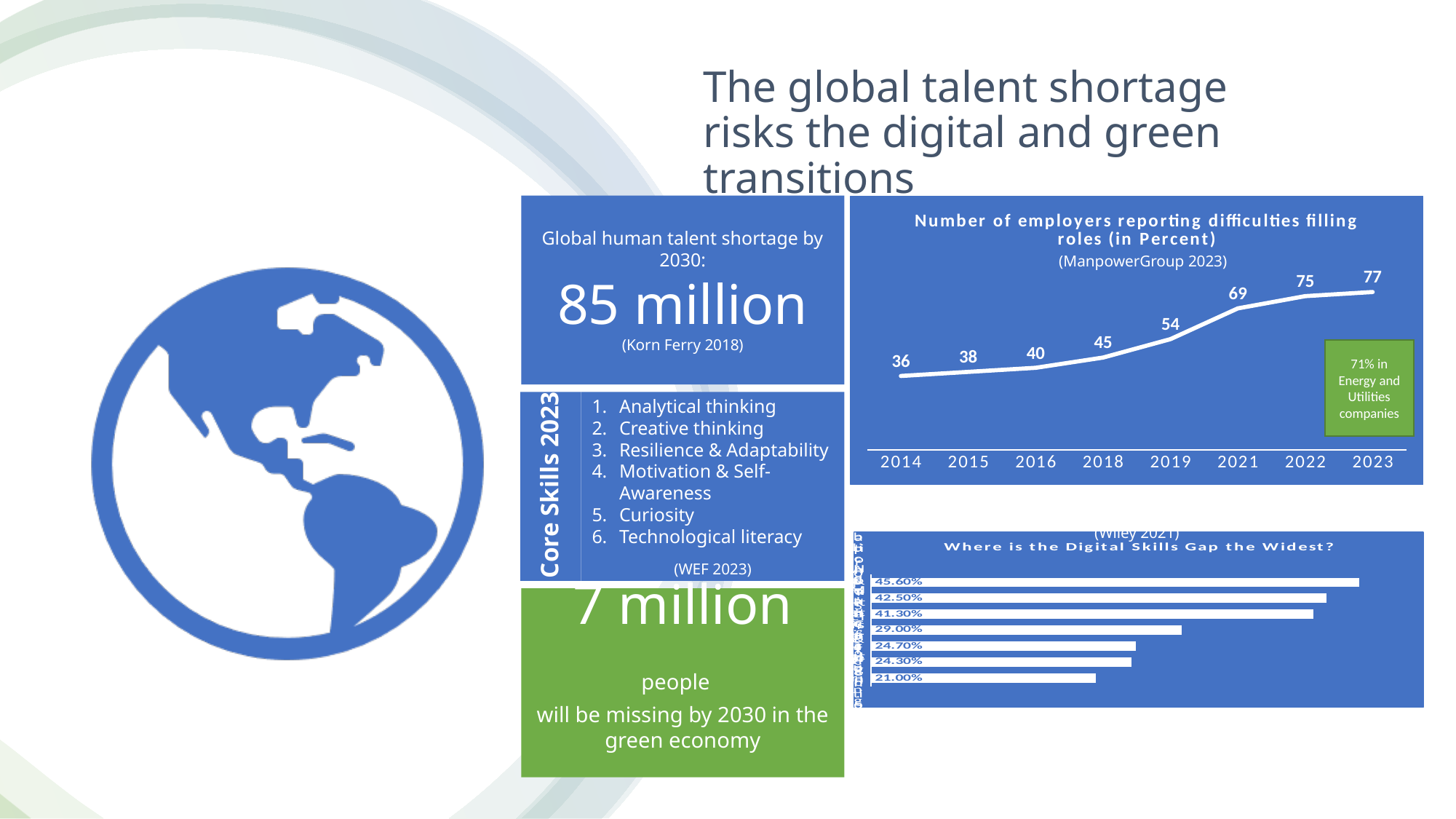
In the chart titled "Number of employers reporting difficulties filling roles (in Percent)", what is the value for 2023? 77 In the chart titled "Number of employers reporting difficulties filling roles (in Percent)", what is the value for 2019? 54 In the chart titled "Number of employers reporting difficulties filling roles (in Percent)", how many years are plotted? 8 In the chart titled "Number of employers reporting difficulties filling roles (in Percent)", which is larger, the value for 2021 or the value for 2018? 2021 What kind of chart is the one titled "Number of employers reporting difficulties filling roles (in Percent)"? line chart In the chart titled "Number of employers reporting difficulties filling roles (in Percent)", what is the value for 2014? 36 In the chart titled "Number of employers reporting difficulties filling roles (in Percent)", which year has the lowest value? 2014 In the chart titled "Where is the Digital Skills Gap the Widest?", how many bars are shown? 7 What kind of chart is the one titled "Where is the Digital Skills Gap the Widest?"? bar chart In the chart titled "Number of employers reporting difficulties filling roles (in Percent)", which year has the highest value? 2023 In the chart titled "Number of employers reporting difficulties filling roles (in Percent)", what is the difference between the values for 2023 and 2014? 41 In the chart titled "Number of employers reporting difficulties filling roles (in Percent)", do the values rise or fall from 2014 to 2023? rise